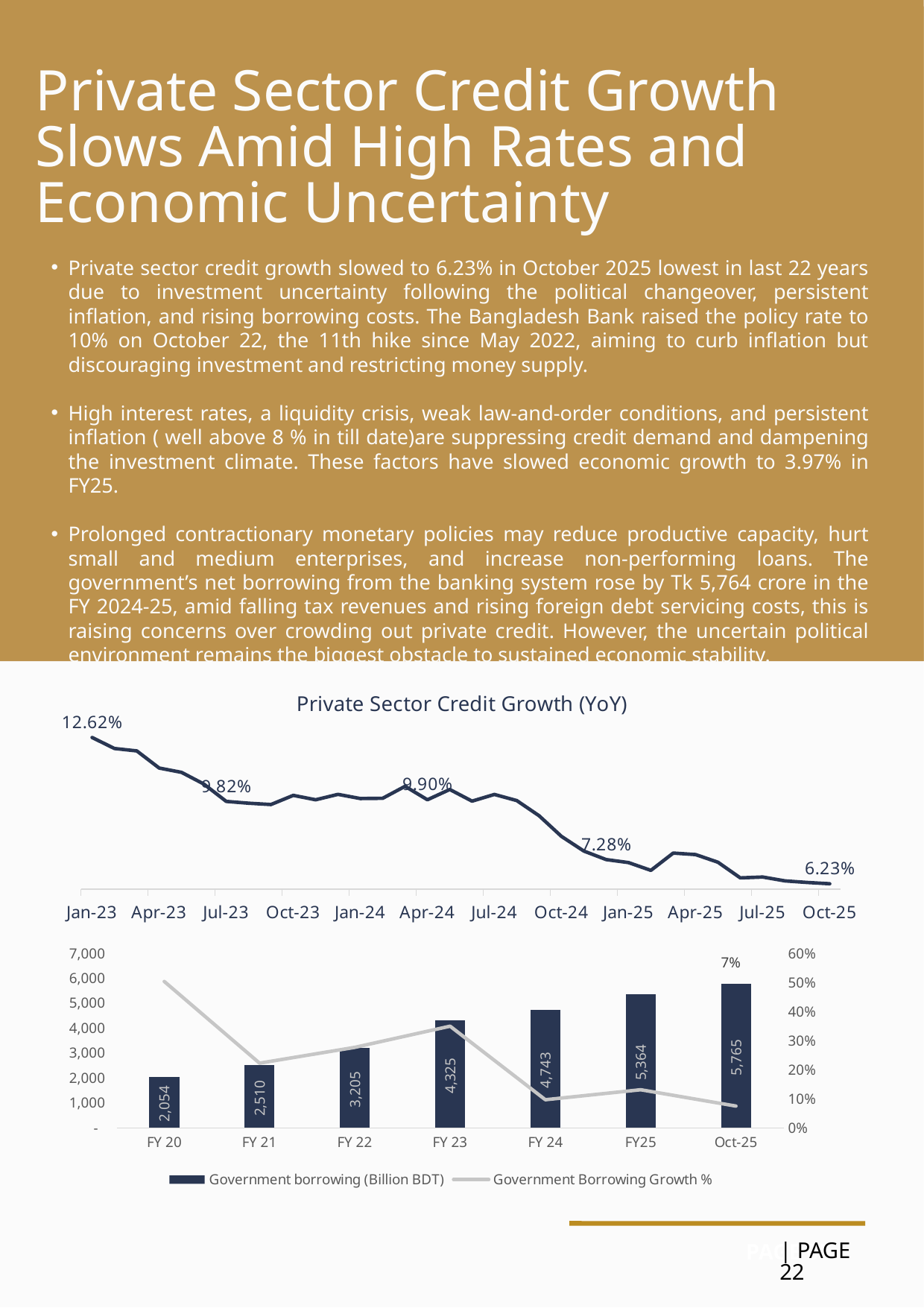
How many periods are shown on the x axis of the bottom chart? 7 On the bottom chart, which period has the highest Government borrowing (Billion BDT)? Oct-25 On the Private Sector Credit Growth (YoY) chart, what is the value shown for Oct-25? 6.23% What kind of chart is the Private Sector Credit Growth (YoY) chart? line chart On the bottom chart, what is the difference in Government borrowing (Billion BDT) between FY25 and FY 24? 621 On the bottom chart, what is the Government Borrowing Growth % shown for Oct-25? 7% On the Private Sector Credit Growth (YoY) chart, what is the value shown for Jan-23? 12.62% On the bottom chart, which period has the lowest Government borrowing (Billion BDT)? FY 20 On the bottom chart, what is the Government borrowing (Billion BDT) for Oct-25? 5,765 How many series does the legend of the bottom chart list? 2 On the Private Sector Credit Growth (YoY) chart, do the values generally rise or fall from Jan-23 to Oct-25? fall On the bottom chart, what is the Government borrowing (Billion BDT) for FY 23? 4,325